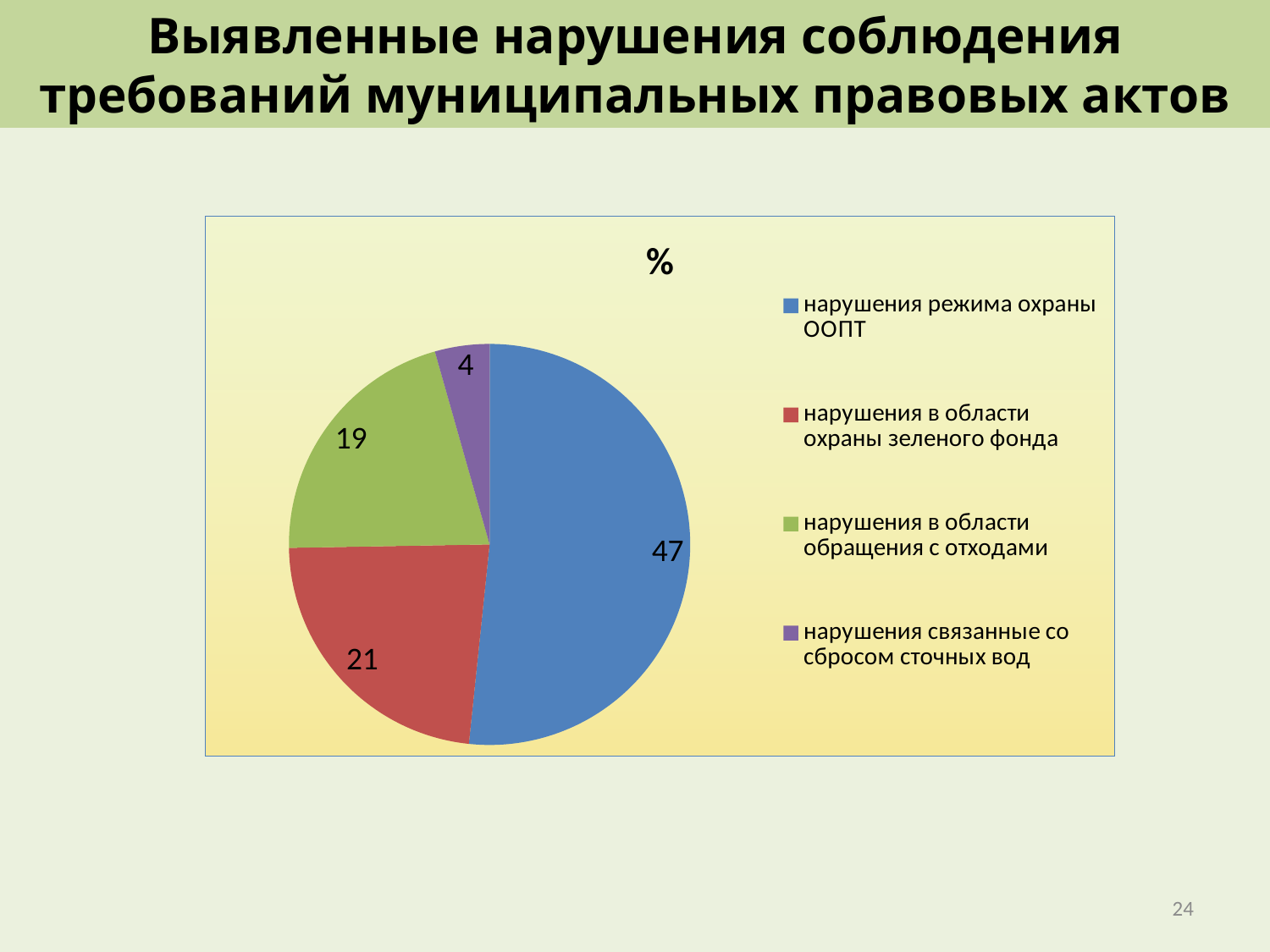
What is the value for нарушения режима охраны ООПТ? 47 What is the value for нарушения в области обращения с отходами? 19 What is the value for нарушения связанные со сбросом сточных вод? 4 Which category has the smallest slice? нарушения связанные со сбросом сточных вод How many categories does the pie chart show? 4 What is the title of the chart? % Which is larger: нарушения в области охраны зеленого фонда or нарушения в области обращения с отходами? нарушения в области охраны зеленого фонда What is the value for нарушения в области охраны зеленого фонда? 21 What colour is the slice for нарушения в области обращения с отходами? green What kind of chart is shown on the slide? pie chart Which category has the largest slice? нарушения режима охраны ООПТ What is the difference between the values for нарушения режима охраны ООПТ and нарушения в области охраны зеленого фонда? 26